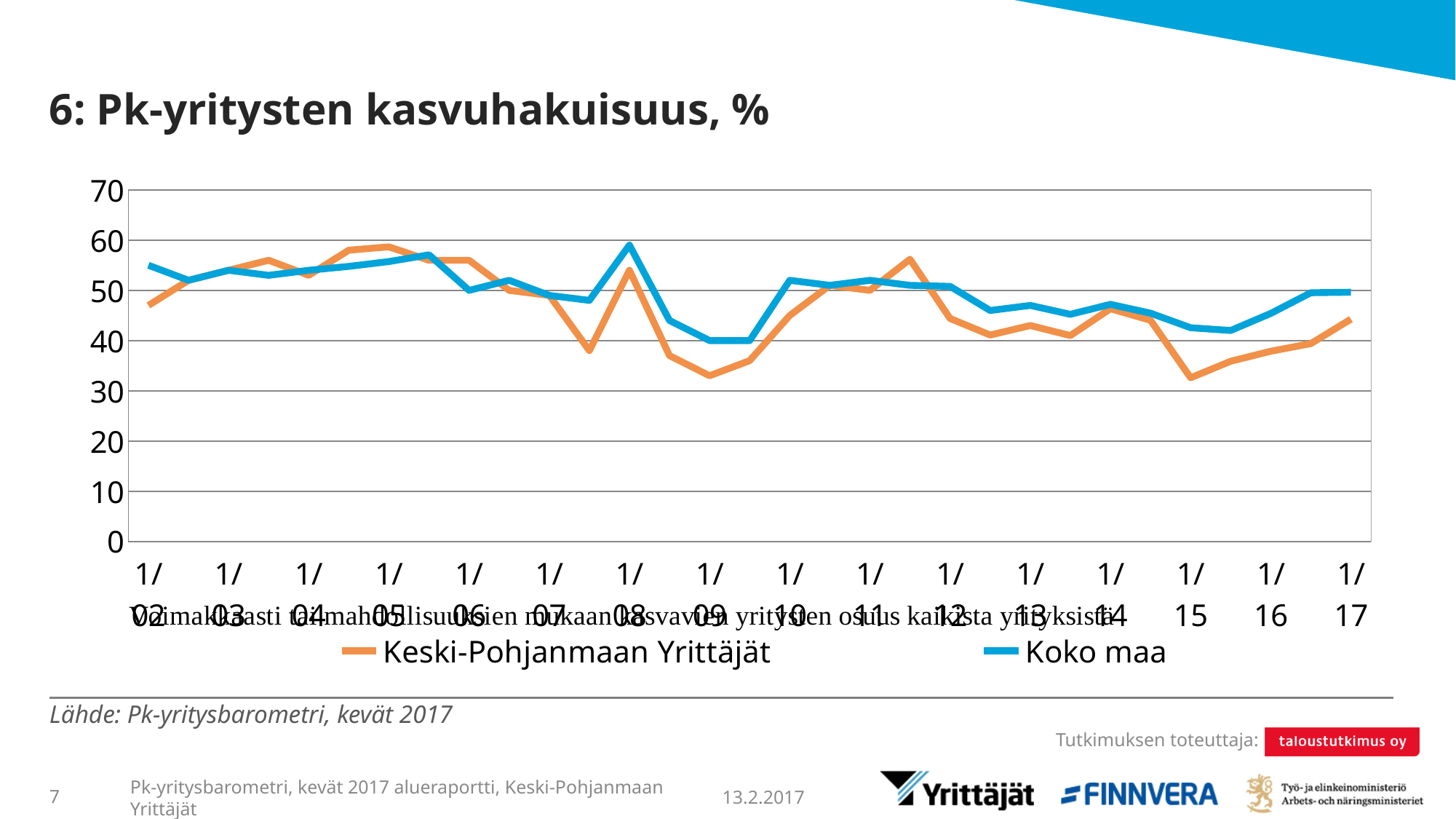
At 1/17, which series has the higher value, Keski-Pohjanmaan Yrittäjät or Koko maa? Koko maa What is the title of the chart? 6: Pk-yritysten kasvuhakuisuus, % Is the value for Keski-Pohjanmaan Yrittäjät at 1/09 greater or less than 40? less How many labelled points are there on the x axis? 16 Does the Keski-Pohjanmaan Yrittäjät line rise or fall from 1/15 to 1/17? rise Is the value for Keski-Pohjanmaan Yrittäjät at 1/05 greater or less than 50? greater At 1/15, which series has the higher value, Keski-Pohjanmaan Yrittäjät or Koko maa? Koko maa Is the value for Koko maa at 1/09 greater or less than 50? less How many series does the legend list? 2 What kind of chart is shown on the slide? line chart